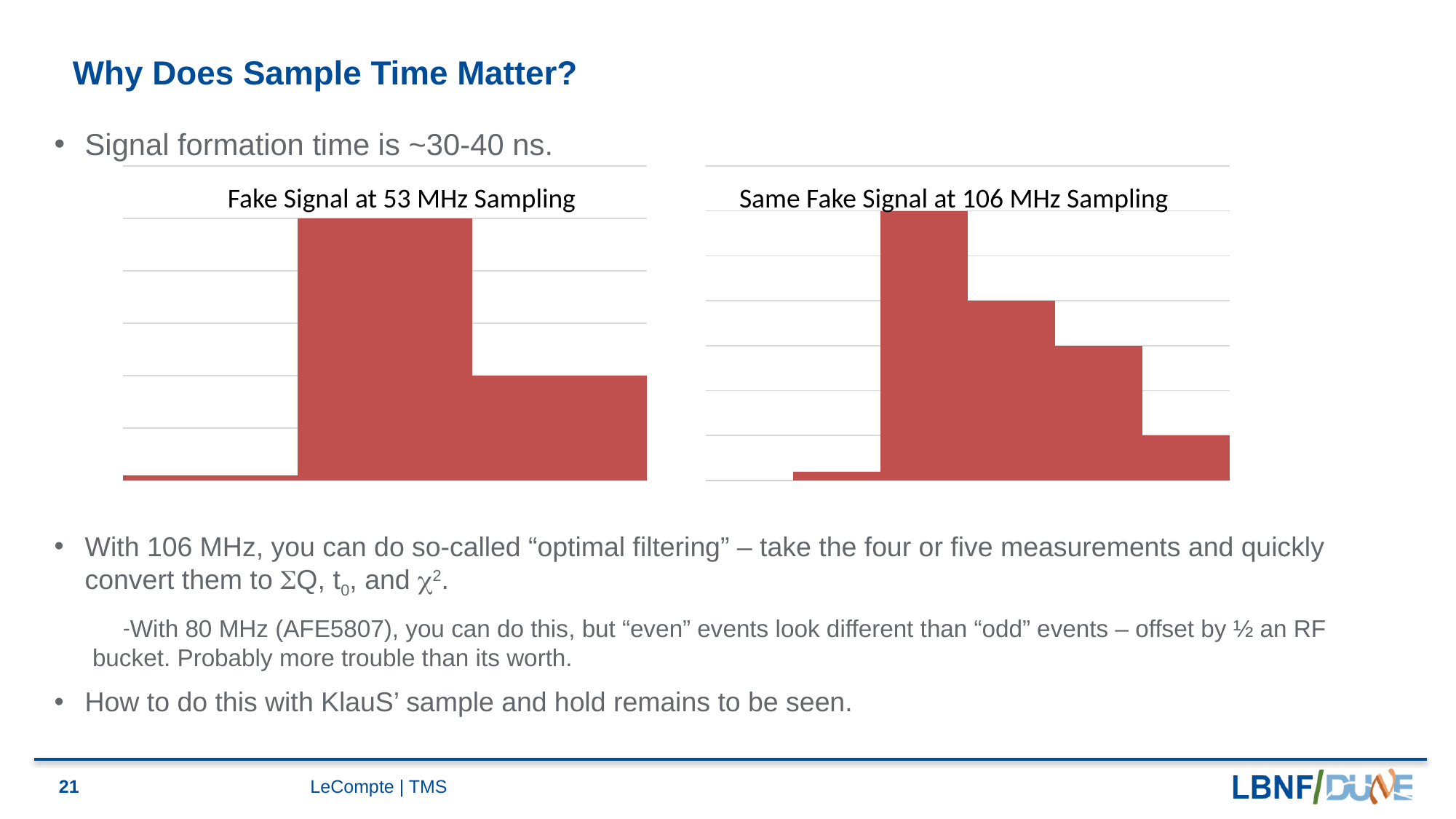
In the chart titled "Same Fake Signal at 106 MHz Sampling", do the bar heights rise or fall moving right from the tallest bar? fall In the chart titled "Fake Signal at 53 MHz Sampling", is the tallest bar to the left or to the right of the shorter wide bar? left What kind of chart is the chart titled "Same Fake Signal at 106 MHz Sampling"? bar chart What is the title of the chart on the right side of the slide? Same Fake Signal at 106 MHz Sampling What kind of chart is the chart titled "Fake Signal at 53 MHz Sampling"? bar chart What is the title of the chart on the left side of the slide? Fake Signal at 53 MHz Sampling